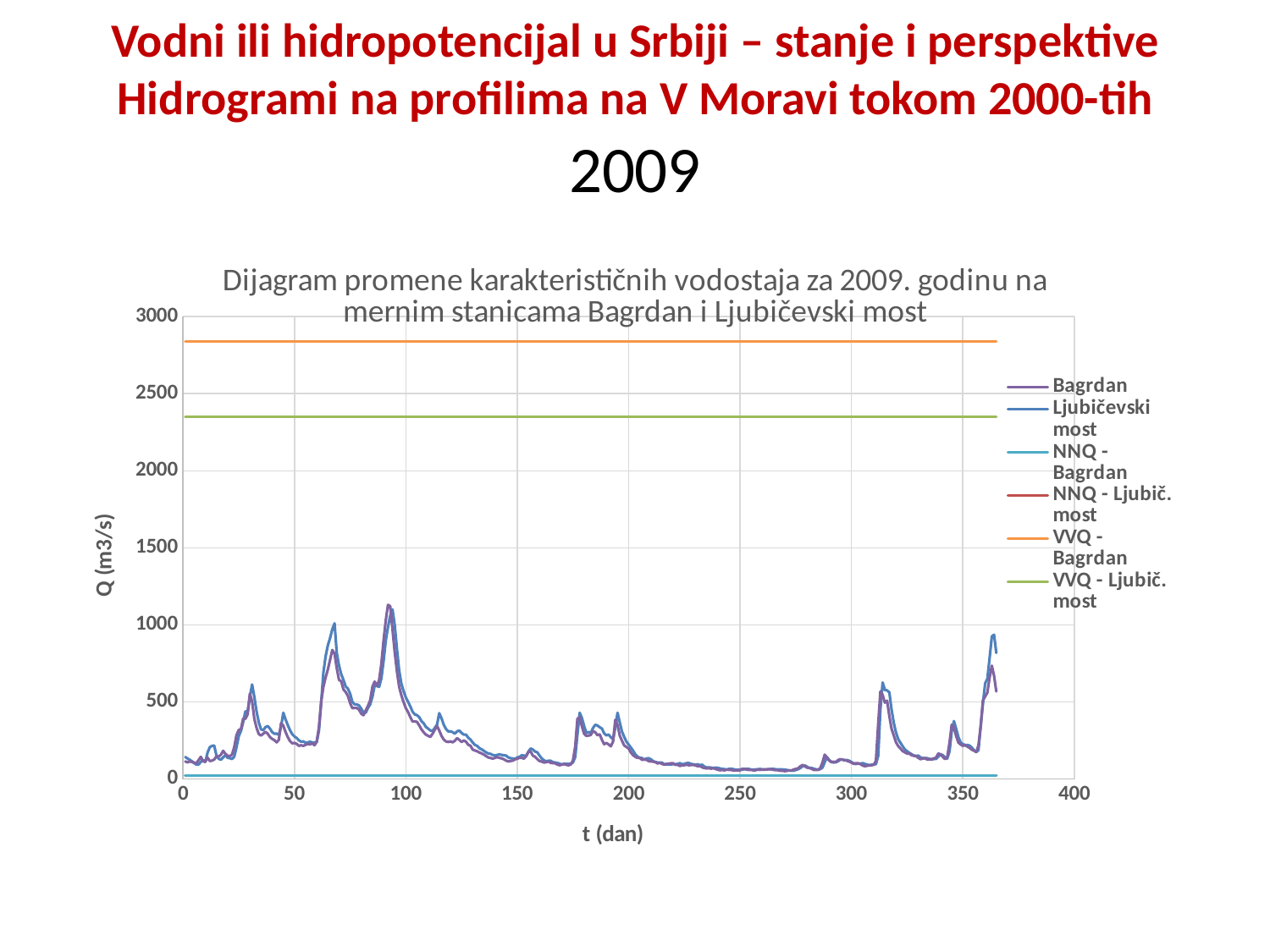
Is the value of the VVQ - Ljubič. most line greater or less than 2000? greater Which is higher, the VVQ - Bagrdan line or the VVQ - Ljubič. most line? VVQ - Bagrdan What is the title of the x axis? t (dan) Is the value of the VVQ - Bagrdan line greater or less than 2500? greater What is the title of the y axis? Q (m3/s) How many series does the legend list? 6 Is the value of the NNQ - Bagrdan line greater or less than 500? less What kind of chart is shown on the slide? line chart Which series has the highest values on the chart? VVQ - Bagrdan